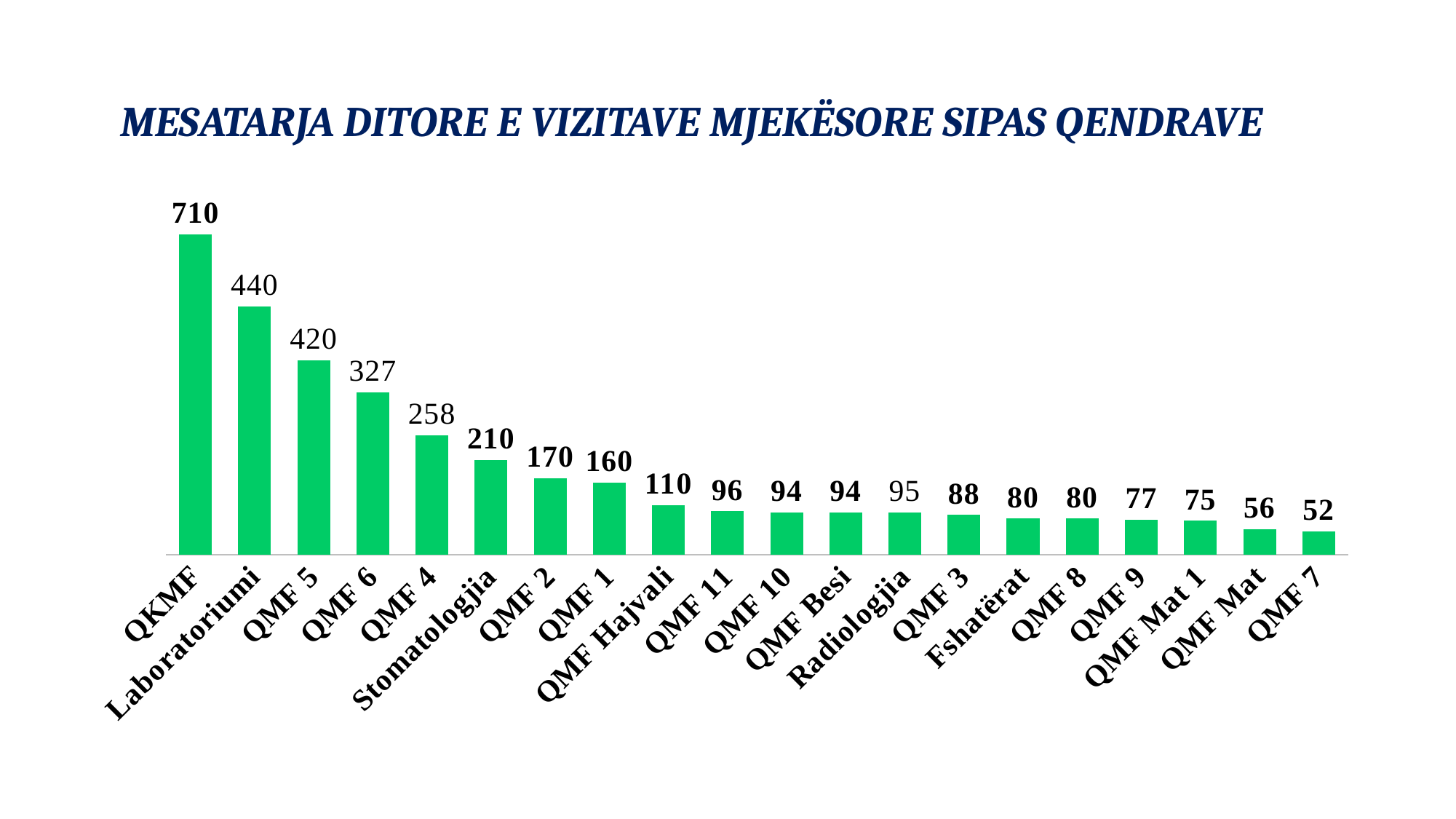
What is the value for Stomatologjia? 210 What is the value for QKMF? 710 Which category has the highest value? QKMF What is the value for QMF Hajvali? 110 What is the value for Radiologjia? 95 How many categories are shown in the chart? 20 What is the title of the chart? MESATARJA DITORE E VIZITAVE MJEKËSORE SIPAS QENDRAVE What kind of chart is shown on the slide? Bar chart Which category has the lowest value? QMF 7 What is the difference between the values for QKMF and Laboratoriumi? 270 Which is larger, the value for QMF 5 or the value for QMF 6? QMF 5 What is the difference between the values for QMF 6 and QMF 4? 69